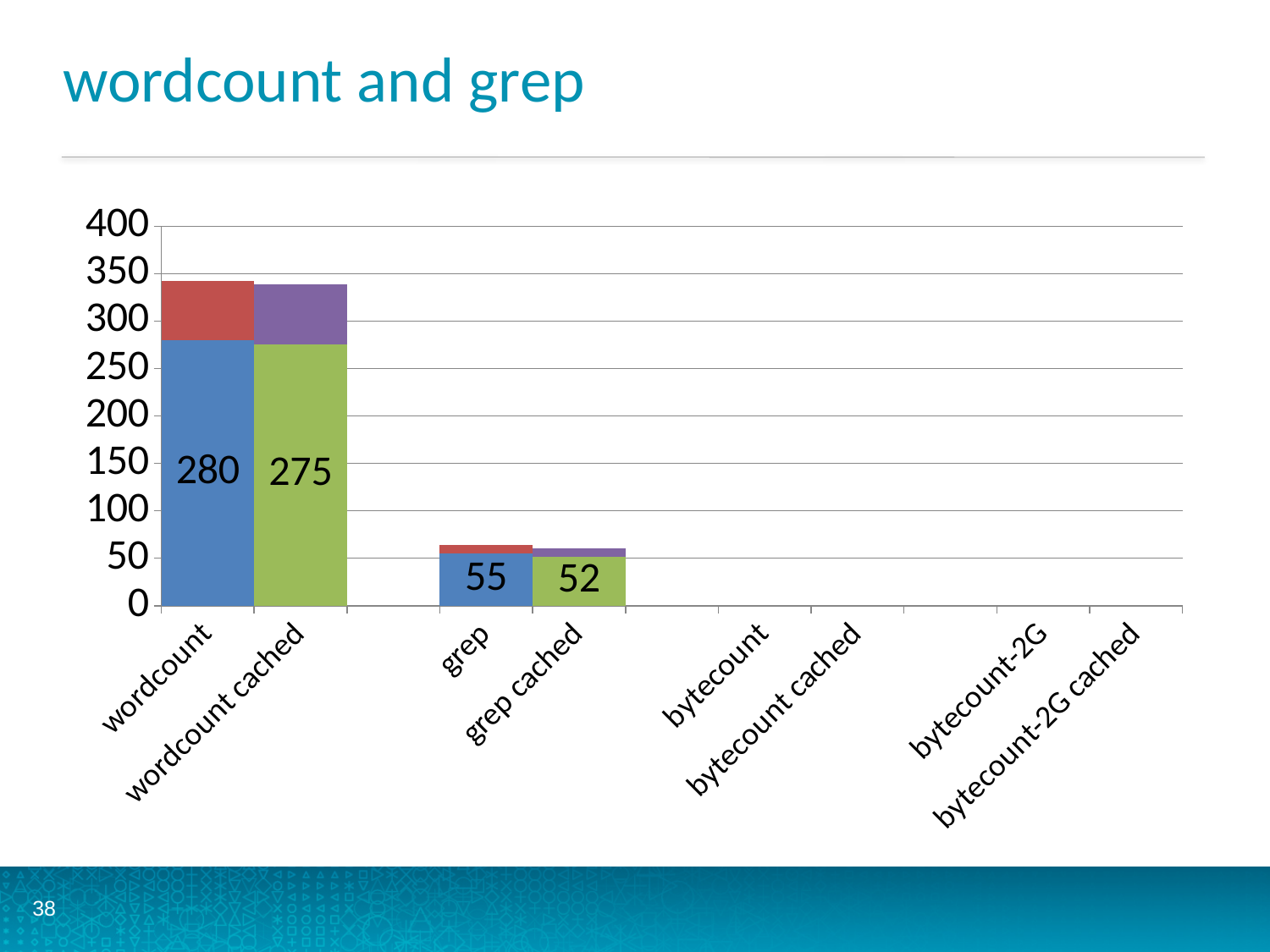
What is the value printed on the bottom segment of the grep cached bar? 52 Which category has the lowest printed value? grep cached What is the difference between the printed values for grep and grep cached? 3 What is the value printed on the bottom segment of the grep bar? 55 How many categories are labelled on the x axis? 8 Which category has the highest printed value? wordcount What is the difference between the printed values for wordcount and wordcount cached? 5 What kind of chart is shown on the slide? stacked bar chart Which is larger, the printed value for grep or for grep cached? grep Is the total height of the wordcount stacked bar greater or less than 300? greater What is the value printed on the bottom segment of the wordcount cached bar? 275 What is the value printed on the bottom segment of the wordcount bar? 280